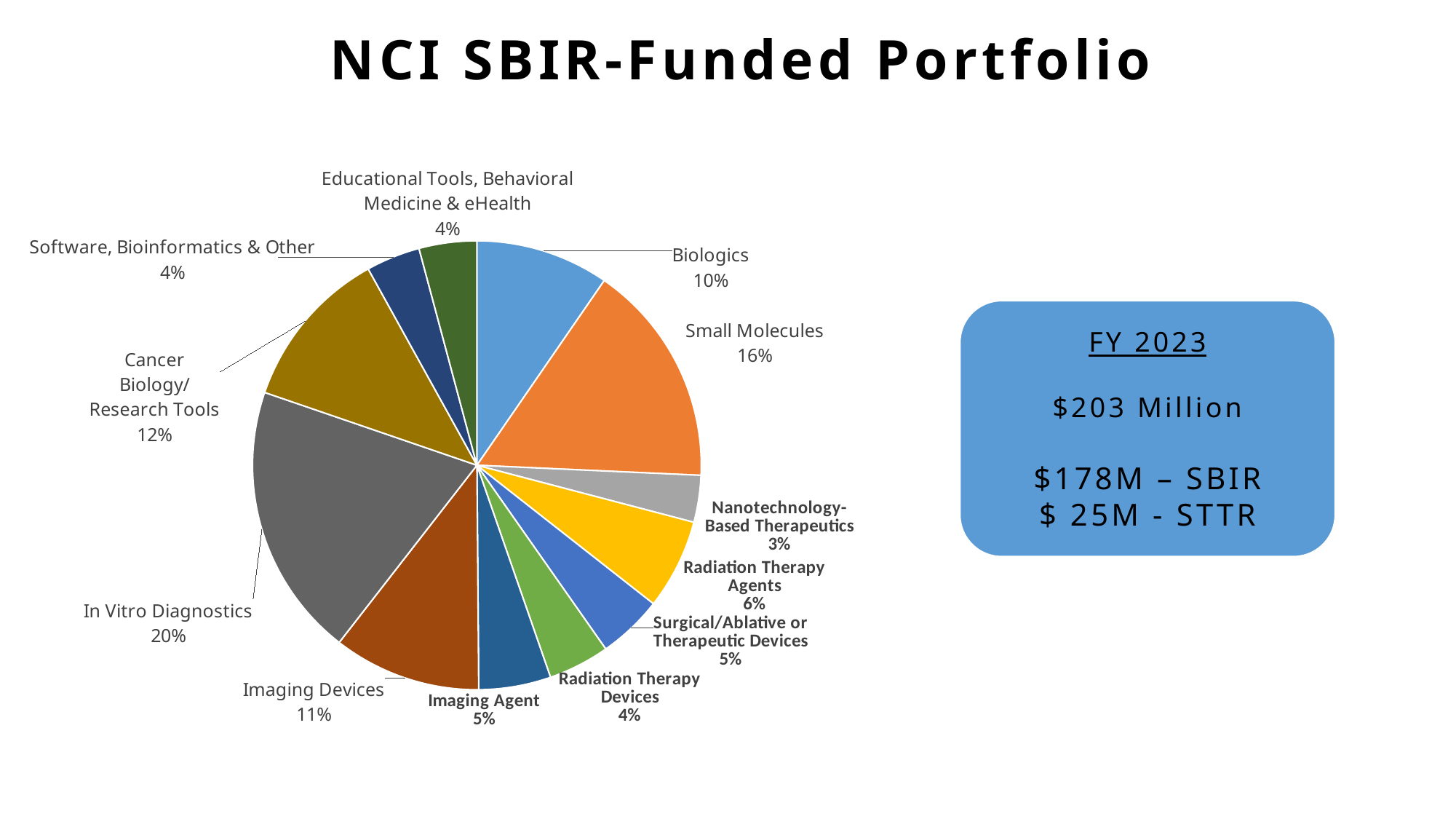
Which category has the largest slice of the pie chart? In Vitro Diagnostics What share of the NCI SBIR-Funded Portfolio is In Vitro Diagnostics? 20% Which category has the smallest slice of the pie chart? Nanotechnology-Based Therapeutics What is the title of the slide containing the pie chart? NCI SBIR-Funded Portfolio What share does Nanotechnology-Based Therapeutics hold in the pie chart? 3% What is the combined share of Radiation Therapy Agents and Radiation Therapy Devices? 10% What percentage of the portfolio is Imaging Agent? 5% How many categories are shown in the pie chart? 12 Which is larger: the share for Biologics or the share for Cancer Biology/Research Tools? Cancer Biology/Research Tools What is the difference in percentage points between In Vitro Diagnostics and Imaging Devices? 9 What percentage of the portfolio is Small Molecules? 16% What type of chart is shown on the slide? pie chart